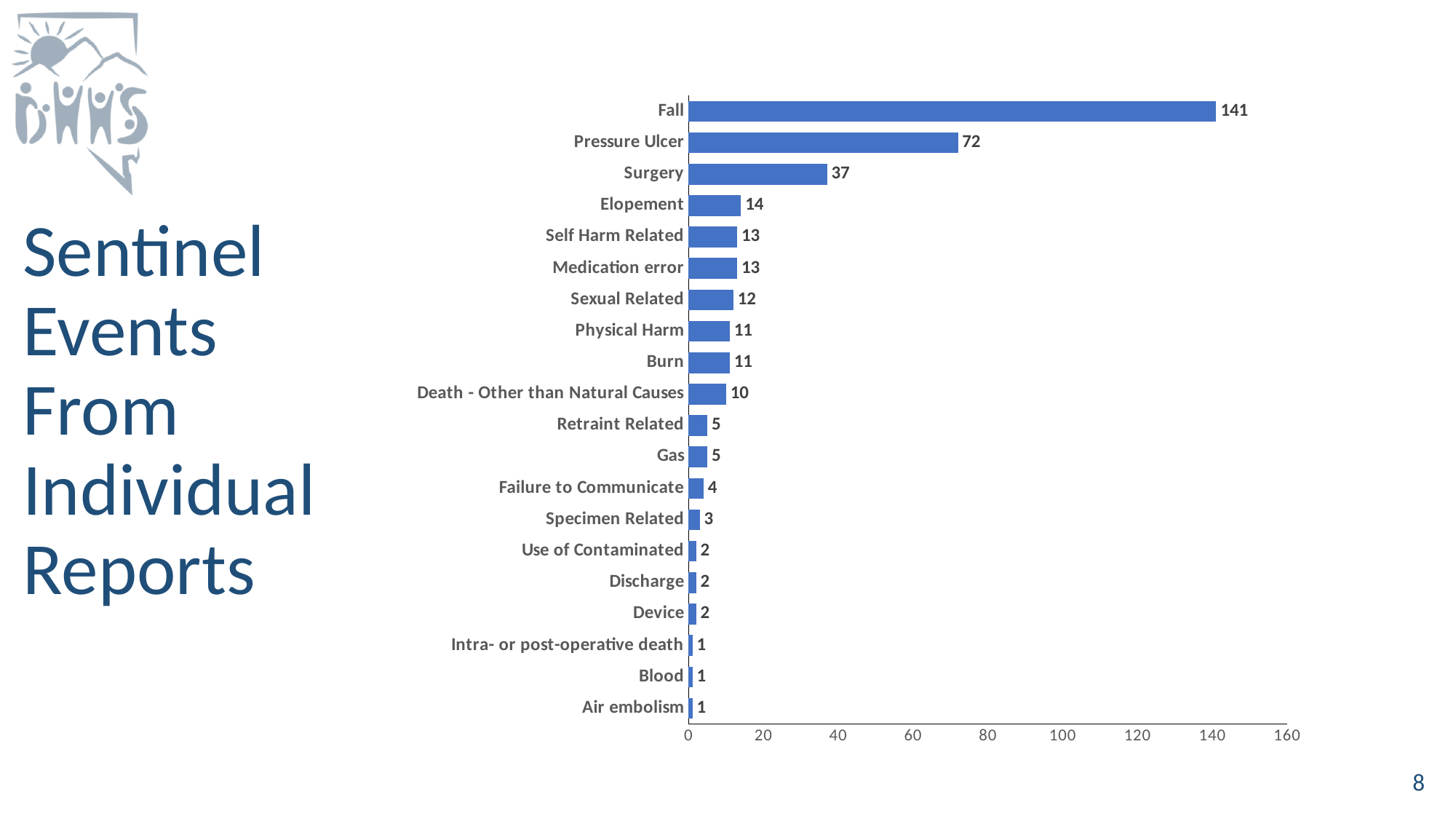
What is the value for Pressure Ulcer? 72 Is the value for Fall greater or less than 140? greater What is the difference between the values for Surgery and Elopement? 23 What is the value for Death - Other than Natural Causes? 10 Which is larger, the value for Sexual Related or the value for Retraint Related? Sexual Related How many categories are shown in the chart? 20 Which category has the highest value? Fall What is the difference between the values for Fall and Pressure Ulcer? 69 What kind of chart is shown on the slide? bar chart What is the value for Fall? 141 What is the title text shown to the left of the chart? Sentinel Events From Individual Reports What is the value for Surgery? 37